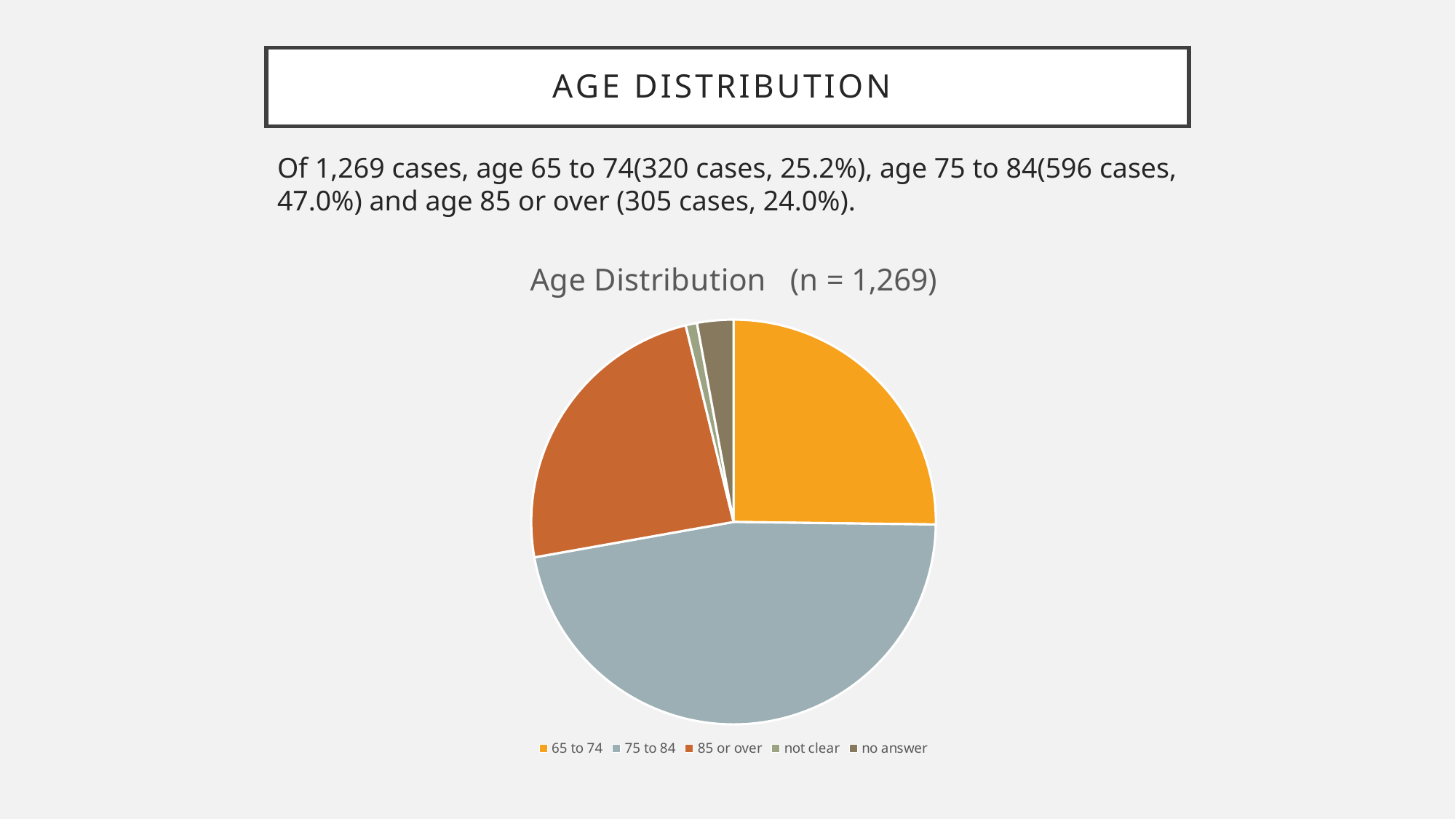
What kind of chart is shown on the slide? pie chart How many categories does the pie chart's legend list? 5 How many cases are in the 85 or over age group? 305 cases What colour is the 75 to 84 slice in the pie chart? grey-blue Which category has the smallest slice of the pie chart? not clear Which age group has the largest slice of the pie chart? 75 to 84 Which has more cases, the 65 to 74 group or the 85 or over group? 65 to 74 What share of cases is in the 65 to 74 age group? 25.2% What share of cases is in the 75 to 84 age group? 47.0% How many more cases are in the 75 to 84 group than in the 65 to 74 group? 276 cases What is the title of the pie chart? Age Distribution (n = 1,269) How many cases are in the 65 to 74 age group? 320 cases